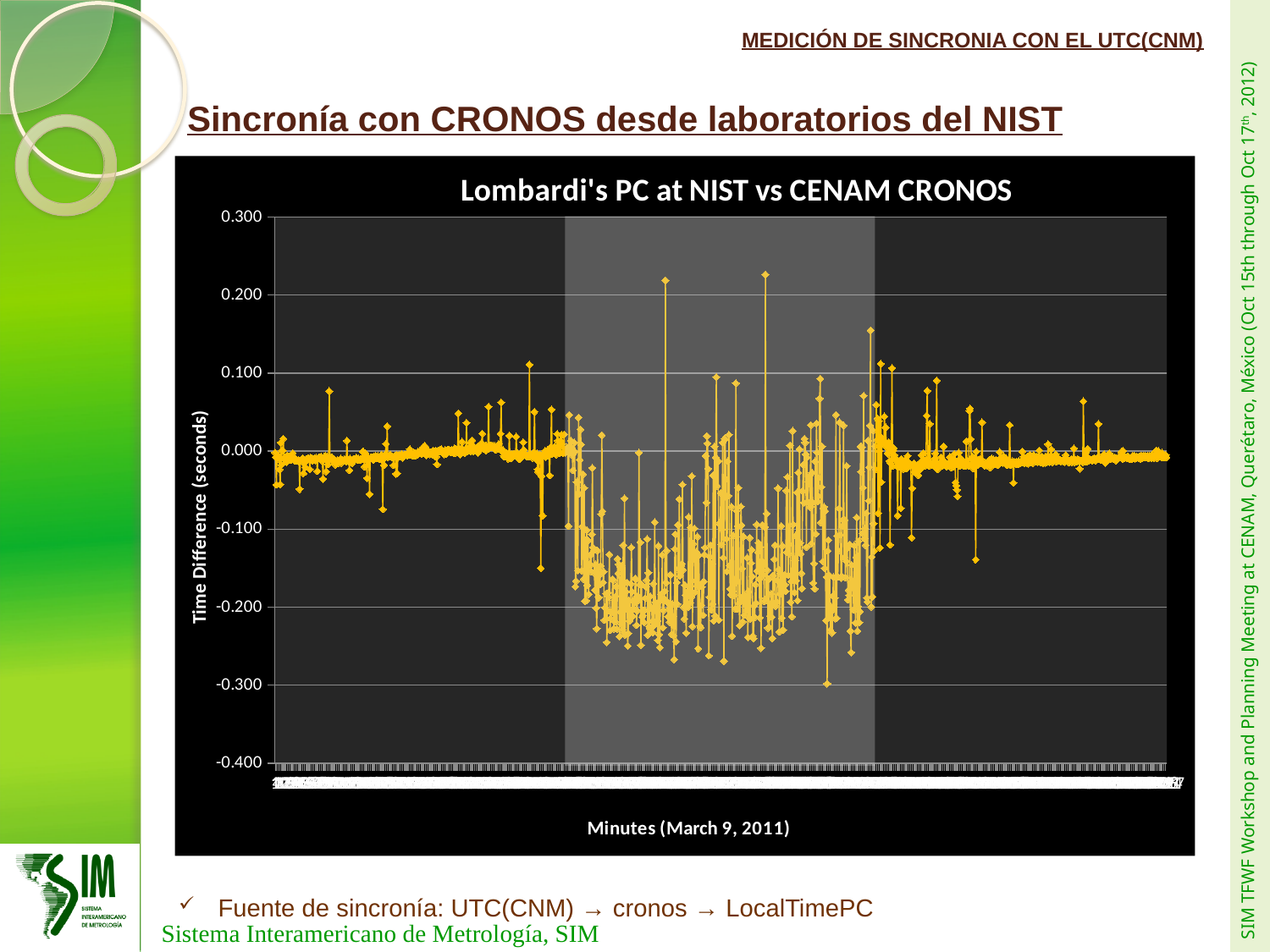
How many data series are plotted in the chart? 1 What is the label of the vertical axis of the chart? Time Difference (seconds) Is the lowest plotted value in the chart greater or less than -0.400? greater What is the title of the chart? Lombardi's PC at NIST vs CENAM CRONOS Are the values at the right end of the chart greater or less than 0.100? less Are the values at the start of the series (left side of the chart) greater or less than -0.100? greater What kind of chart is shown on the slide? line chart